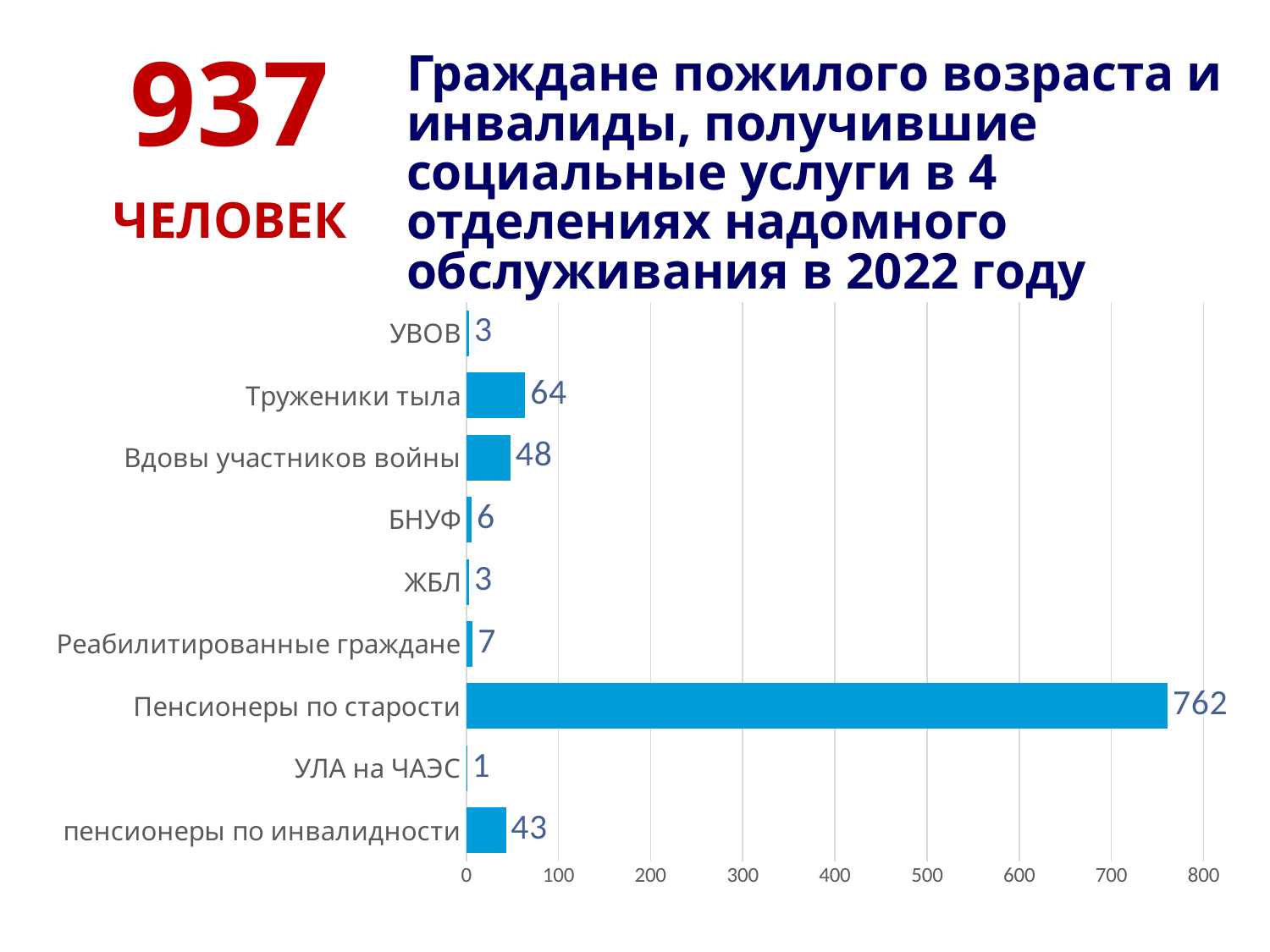
What kind of chart is shown on the slide? bar chart How many categories are shown in the chart? 9 What is the value for Труженики тыла? 64 What is the value for пенсионеры по инвалидности? 43 What is the value for Пенсионеры по старости? 762 Which category has the lowest value? УЛА на ЧАЭС What is the total number of people stated in red on the slide? 937 ЧЕЛОВЕК Is the value for Пенсионеры по старости greater or less than 700? greater Which category has the highest value? Пенсионеры по старости Which is larger, the value for Вдовы участников войны or the value for пенсионеры по инвалидности? Вдовы участников войны What is the difference between the values for Труженики тыла and Вдовы участников войны? 16 What is the value for Вдовы участников войны? 48